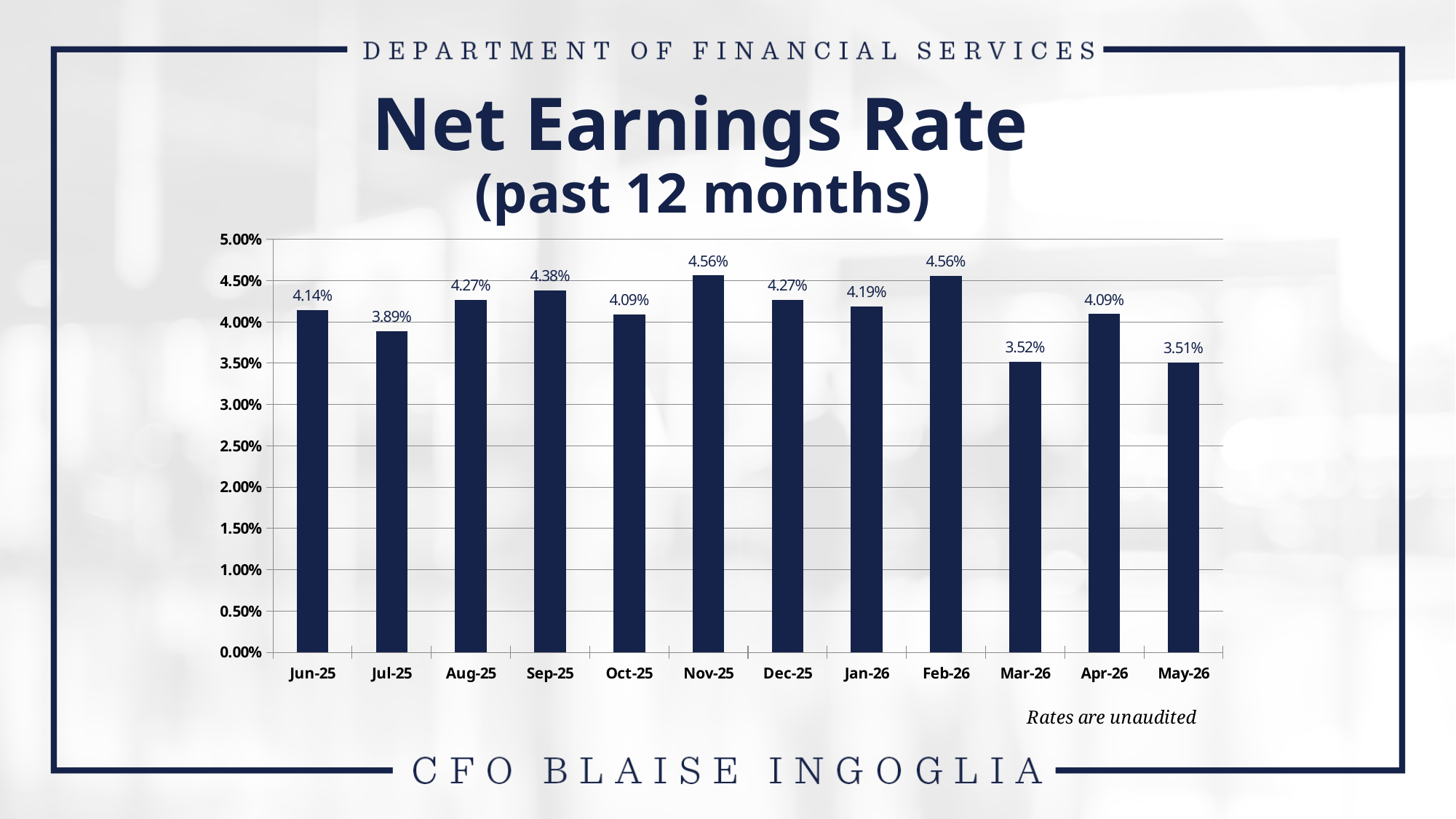
What is the difference between the net earnings rate for Sep-25 and Oct-25? 0.29% What is the net earnings rate for Sep-25? 4.38% What kind of chart is shown on the slide? bar chart What is the difference between the net earnings rate for Feb-26 and Mar-26? 1.04% Which is larger, the net earnings rate for Aug-25 or Jan-26? Aug-25 What note appears below the chart about the rates? Rates are unaudited How many months are shown on the chart? 12 What is the net earnings rate for Jul-25? 3.89% Which two months share the highest net earnings rate? Nov-25 and Feb-26 What is the net earnings rate for Nov-25? 4.56% Is the net earnings rate for May-26 greater or less than 4.00%? less What is the net earnings rate for Mar-26? 3.52%